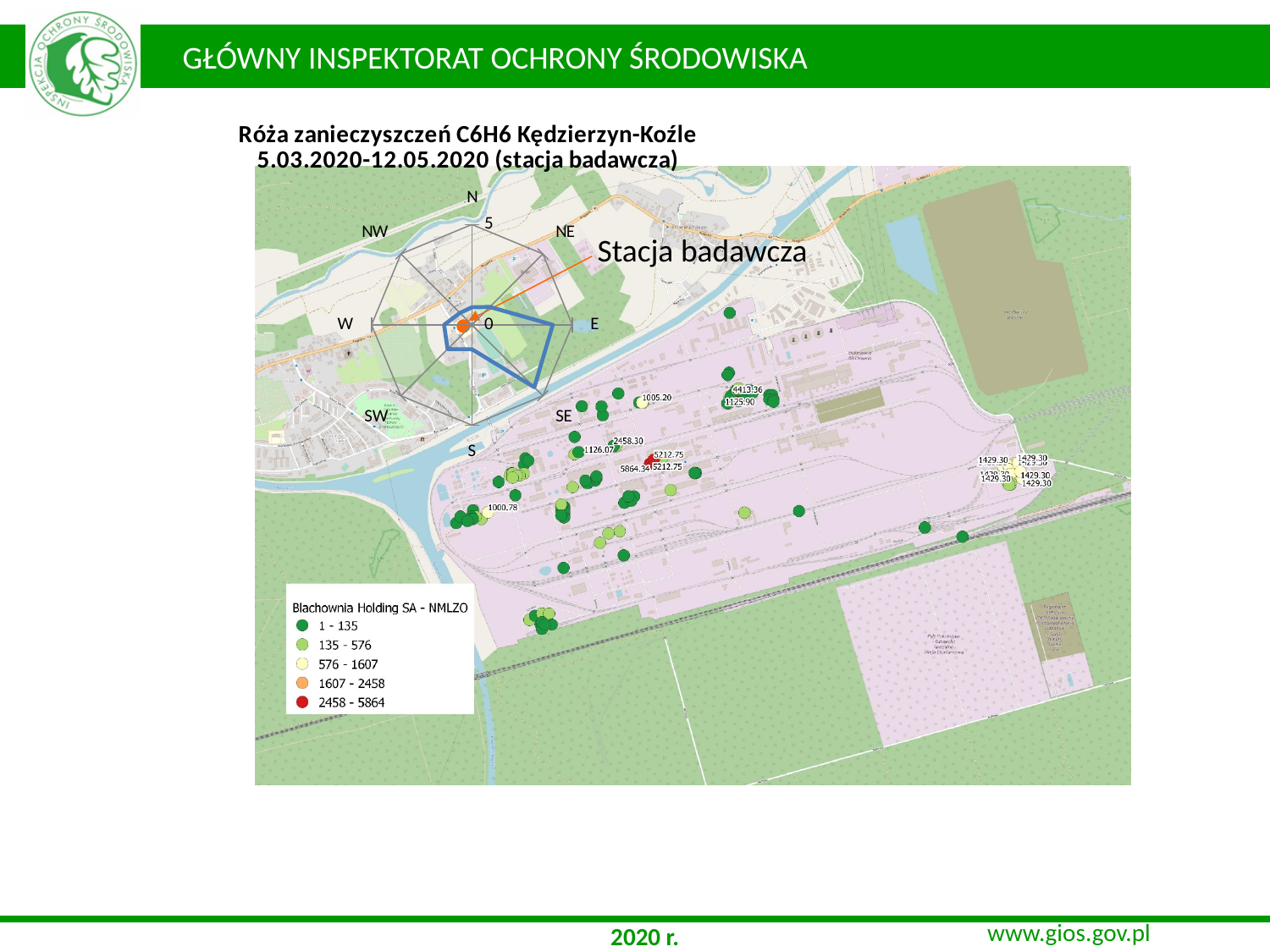
How many compass directions are labelled on the pollution rose? 8 Is the value of the pollution rose in the E direction greater or less than 5? less Which pollutant does the pollution rose for Kędzierzyn-Koźle show, according to the title? C6H6 What kind of chart is the pollution rose (róża zanieczyszczeń) overlaid on the map? radar chart What is the highest value shown on the scale of the pollution rose? 5 Is the value of the pollution rose in the W direction greater or less than 5? less